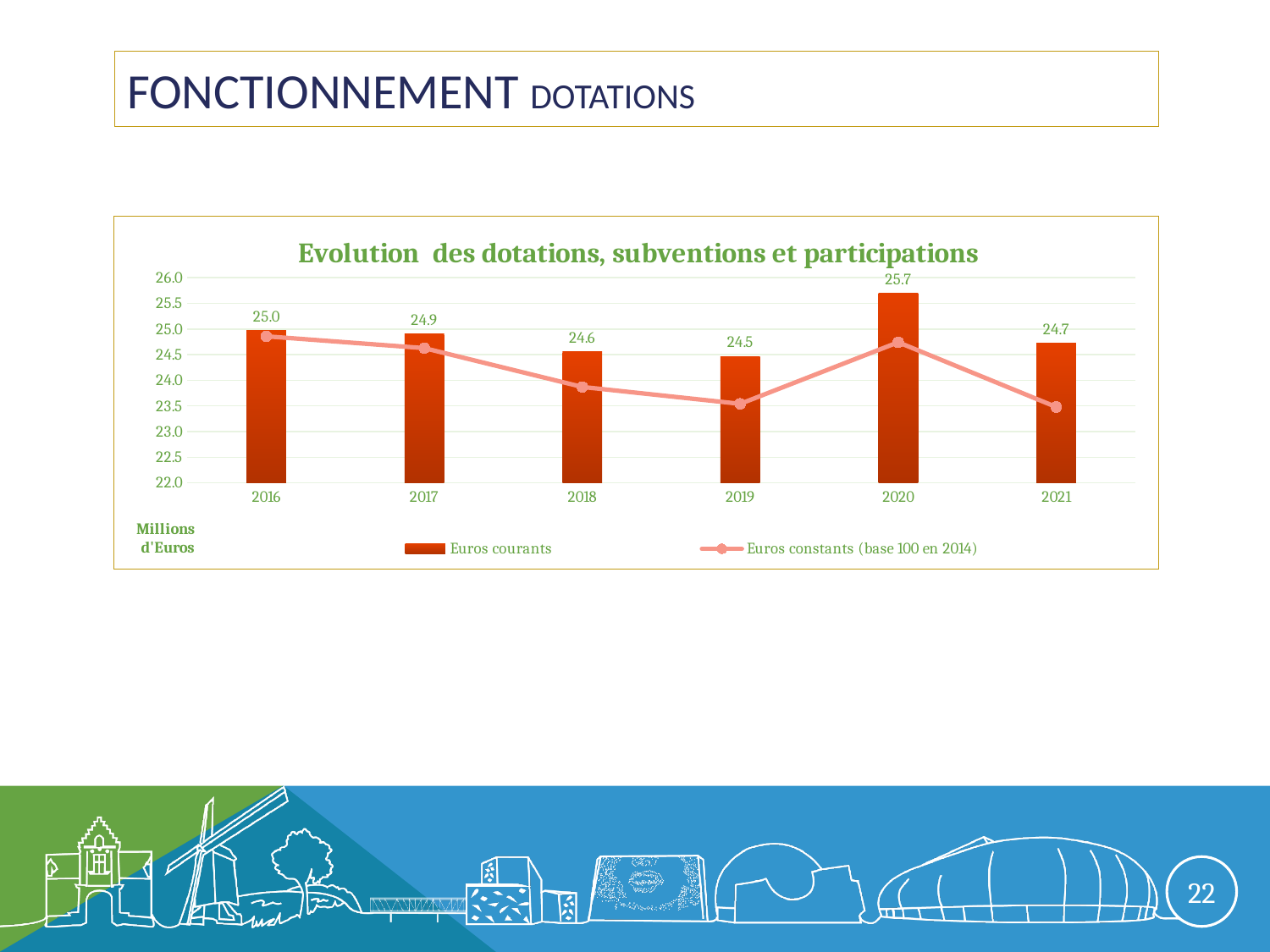
What is the Euros courants value for 2020? 25.7 How many series does the legend list? 2 Which year has the lowest Euros courants value? 2019 Which is larger, the Euros courants value for 2016 or for 2021? 2016 What kind of chart is shown? Combined bar and line chart Which year has the highest Euros courants value? 2020 What is the Euros courants value for 2018? 24.6 What is the title of the chart? Evolution des dotations, subventions et participations Is the Euros constants value for 2016 greater or less than 24.5? greater Is the Euros constants value for 2019 greater or less than 24.0? less What is the difference between the Euros courants values for 2020 and 2019? 1.2 How many years are shown on the x axis? 6